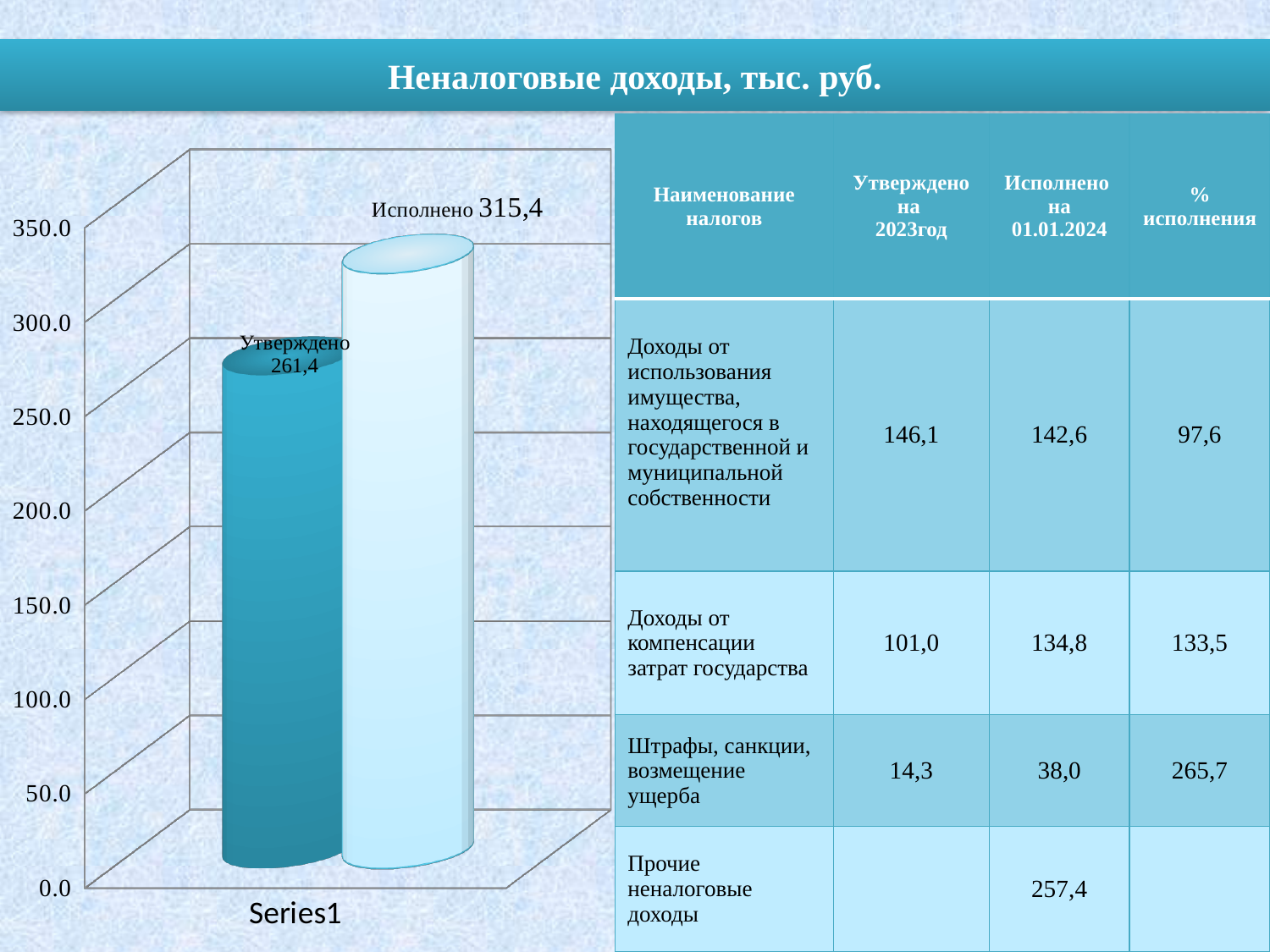
What is the difference between the Исполнено value and the Утверждено value? 54,0 Which bar is higher, Утверждено or Исполнено? Исполнено Which bar has the lowest value? Утверждено Is the value for Утверждено greater or less than 250.0? greater Is the Утверждено value larger or smaller than the Исполнено value? smaller Is the value for Исполнено greater or less than 350.0? less What kind of chart is shown on the slide? bar chart What is the value of the Утверждено bar? 261,4 What label appears on the category axis below the bars? Series1 What is the title of the slide above the chart? Неналоговые доходы, тыс. руб. What is the value of the Исполнено bar? 315,4 How many bars are plotted in the chart? 2